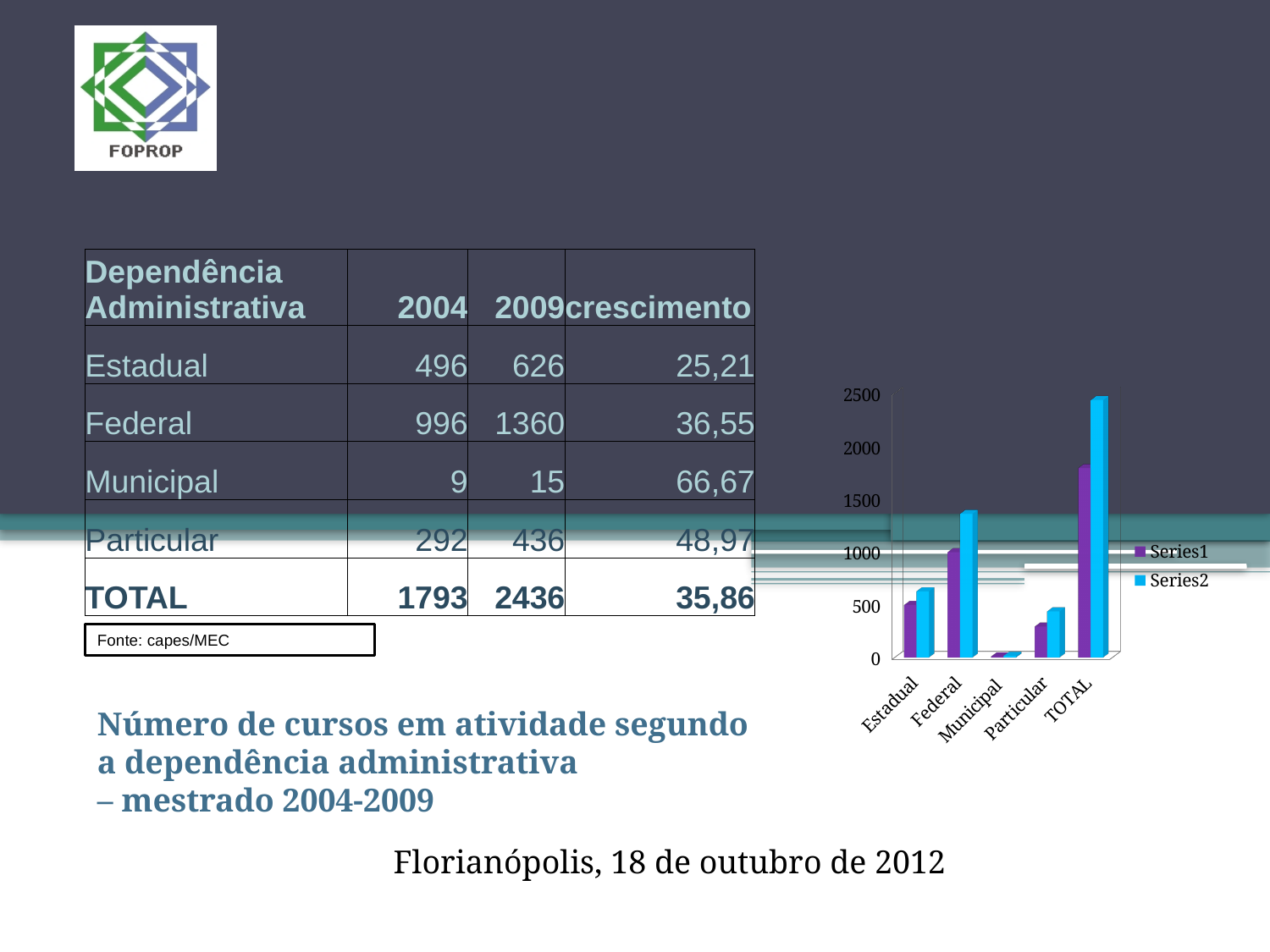
How many categories are shown on the x axis of the bar chart? 5 In the bar chart, which is larger for Federal: Series1 or Series2? Series2 What are the two legend entries of the bar chart? Series1 and Series2 In the bar chart, is the Series2 value for TOTAL greater or less than 2000? greater What kind of chart is shown on the right of the slide? bar chart Which category has the shortest bars in the bar chart? Municipal In the bar chart, is the Series1 value for TOTAL greater or less than 2000? less In the bar chart, is the Series2 value for Federal greater or less than 1000? greater Which category has the tallest bars in the bar chart? TOTAL How many series does the legend of the bar chart list? 2